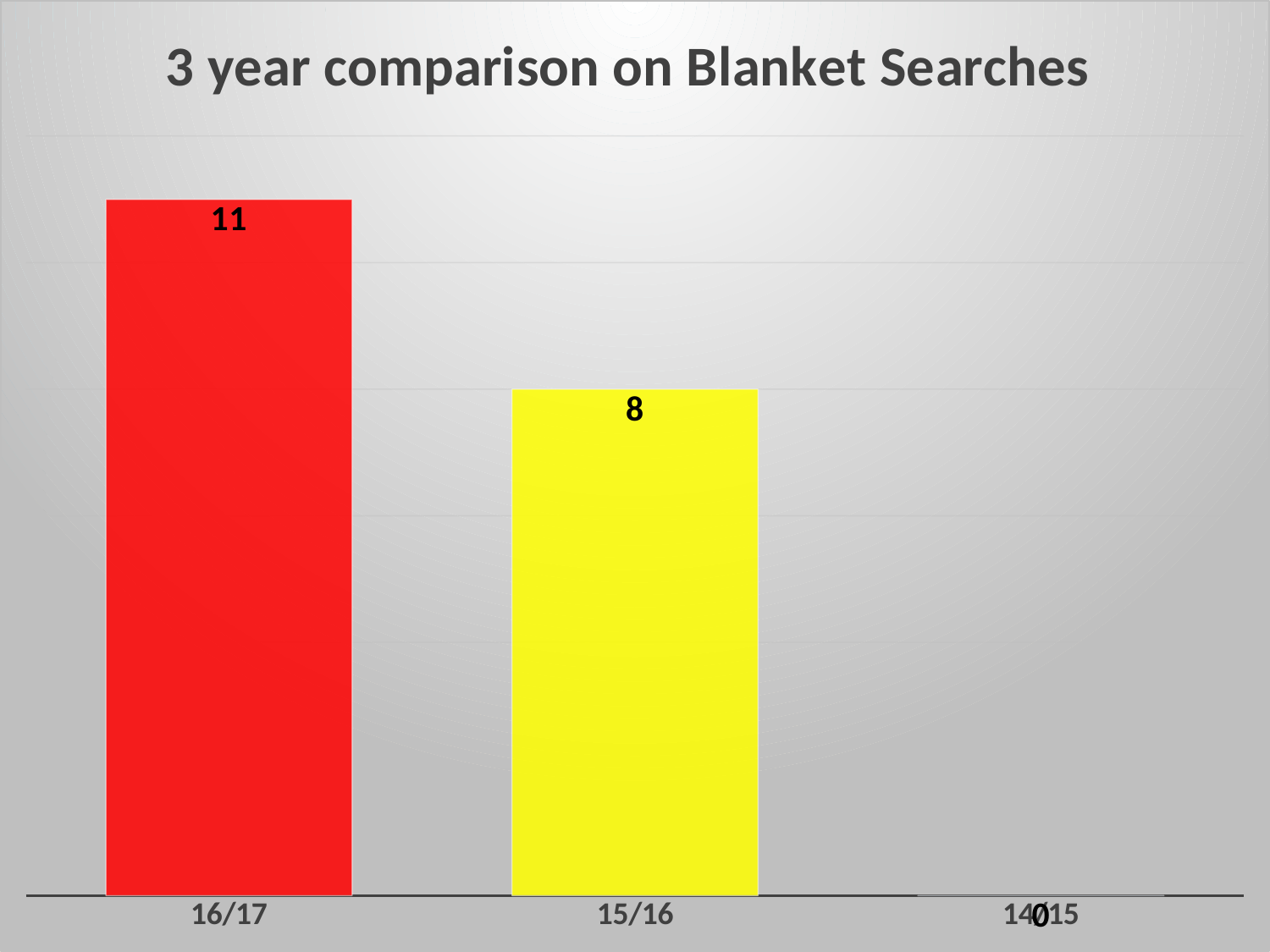
Which year has the lowest value? 14/15 Which year has the highest value? 16/17 Which is larger, the value for 16/17 or the value for 15/16? 16/17 What is the value for 16/17? 11 What is the title of the chart? 3 year comparison on Blanket Searches What kind of chart is shown on the slide? Bar chart What colour is the bar for 15/16? Yellow What is the value for 15/16? 8 How many categories are shown on the chart? 3 What is the difference between the values for 16/17 and 15/16? 3 What is the value for 14/15? 0 Do the values rise or fall from left to right along the x axis? Fall